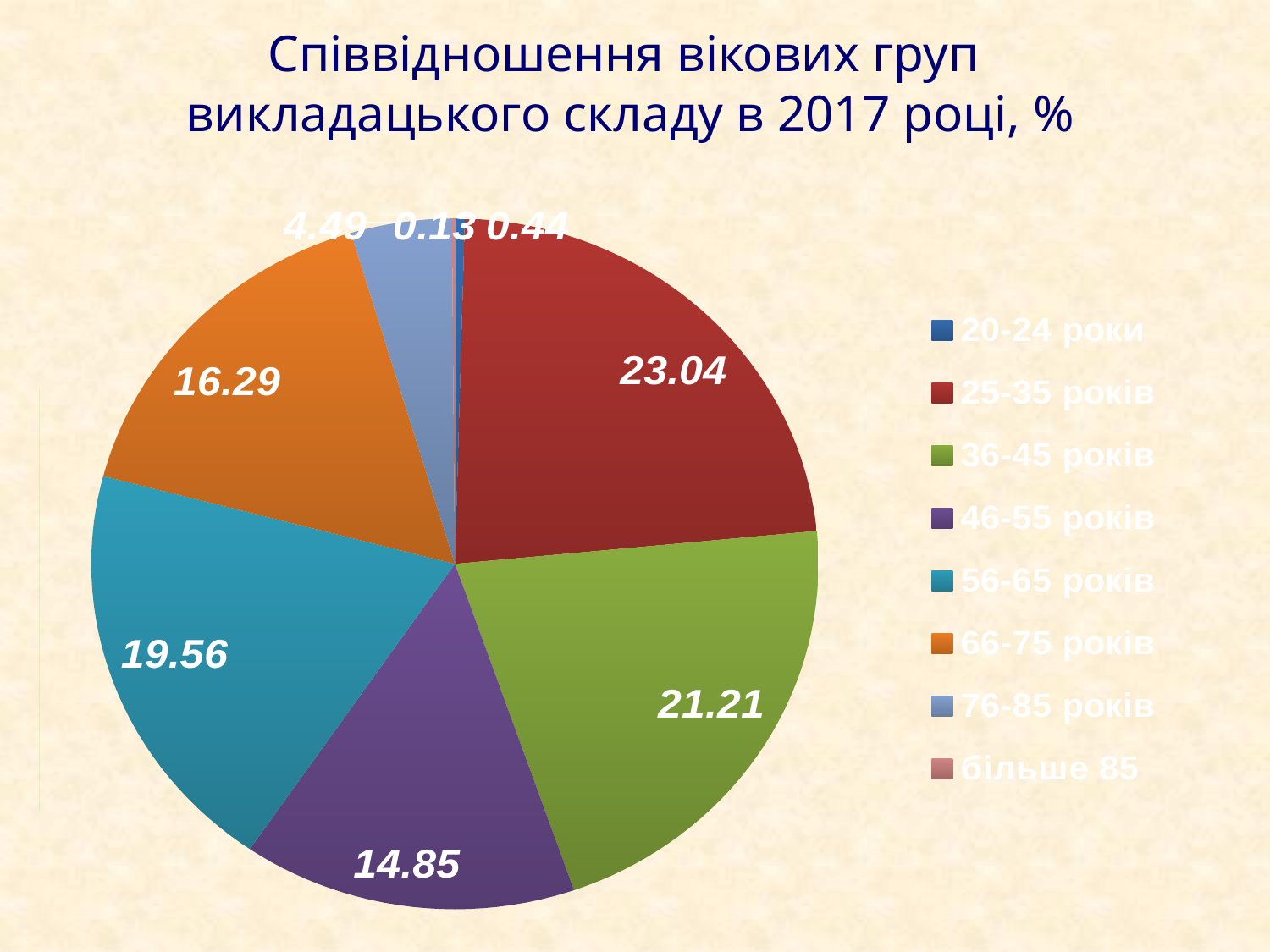
Which age group has the smallest slice of the pie? більше 85 What is the difference between the values for 56-65 років and 66-75 років? 3.27 What value is shown for the 76-85 років slice? 4.49 What value is shown for the 46-55 років slice? 14.85 How many age groups does the legend list? 8 Which is larger, the slice for 36-45 років or the slice for 46-55 років? 36-45 років What colour is the slice for 66-75 років? orange What is the difference between the values for 25-35 років and 36-45 років? 1.83 What value is shown for the 25-35 років slice? 23.04 What value is shown for the 56-65 років slice? 19.56 What kind of chart is shown on the slide? pie chart Which age group has the largest slice of the pie? 25-35 років